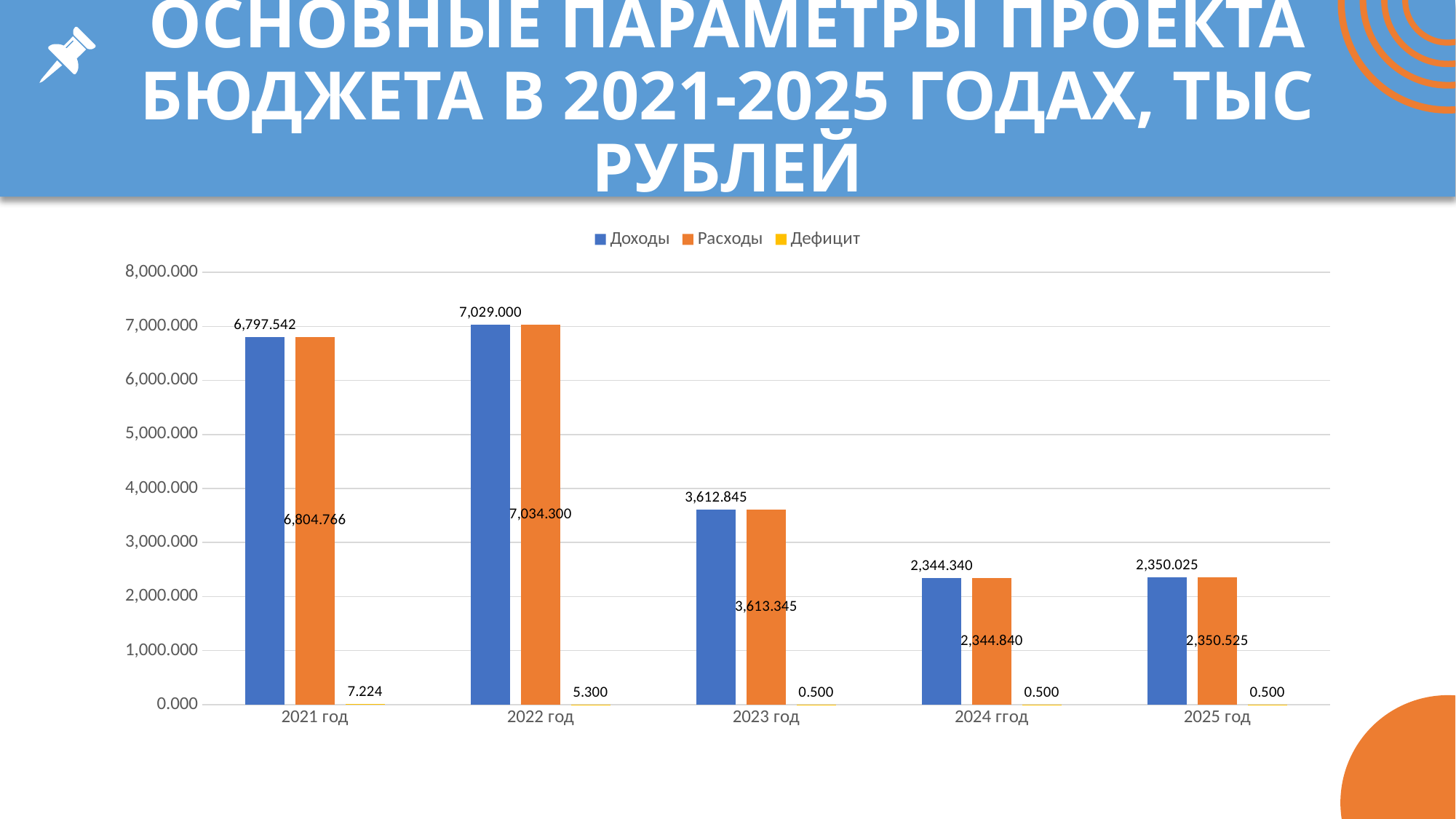
Which is larger: Доходы in 2021 год or Доходы in 2023 год? Доходы in 2021 год How many series does the legend list? 3 In which year is Дефицит highest? 2021 год How many years are shown on the x axis? 5 What is the value of Дефицит for 2022 год? 5.300 What is the value of Доходы for 2021 год? 6,797.542 What is the value of Расходы for 2025 год? 2,350.525 Is the value of Доходы for 2023 год greater or less than 4,000.000? less What kind of chart is shown on the slide? bar chart In which year is Доходы highest? 2022 год What is the difference between Расходы and Доходы in 2021 год? 7.224 What is the value of Расходы for 2023 год? 3,613.345